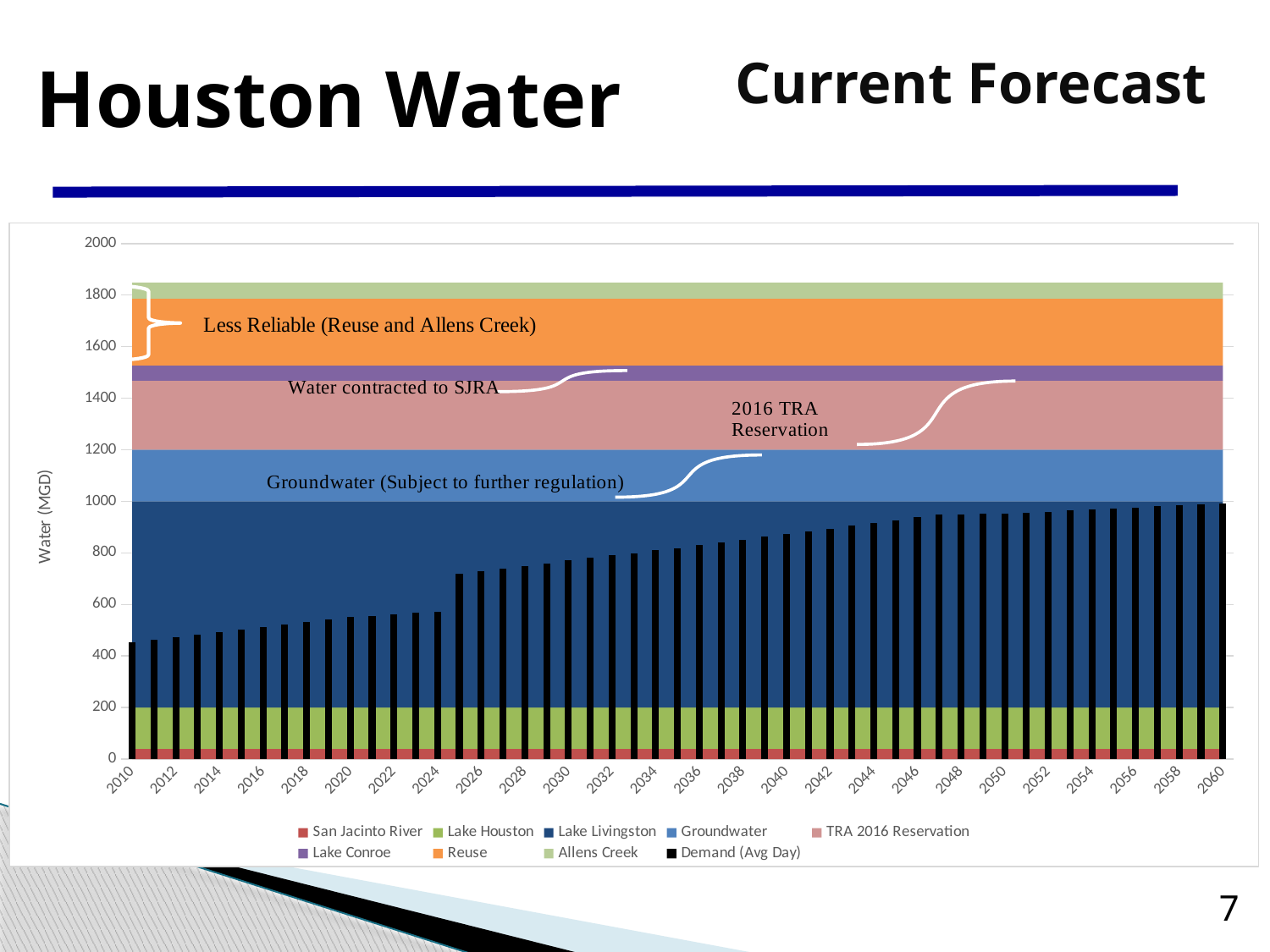
Is the Demand (Avg Day) value for 2060 greater or less than 800? greater What is the highest value shown on the vertical axis? 2000 What are the first and last years shown on the horizontal axis? 2010 and 2060 In which year is the Demand (Avg Day) bar highest? 2060 Does the Demand (Avg Day) series rise or fall from 2010 to 2060? rise Is the Demand (Avg Day) value for 2030 greater or less than 600? greater Is the Demand (Avg Day) value for 2010 greater or less than 600? less In which year is the Demand (Avg Day) bar lowest? 2010 What is the label on the vertical axis of the chart? Water (MGD) How many series does the chart legend list? 9 Which is larger, the Demand (Avg Day) value for 2020 or for 2050? 2050